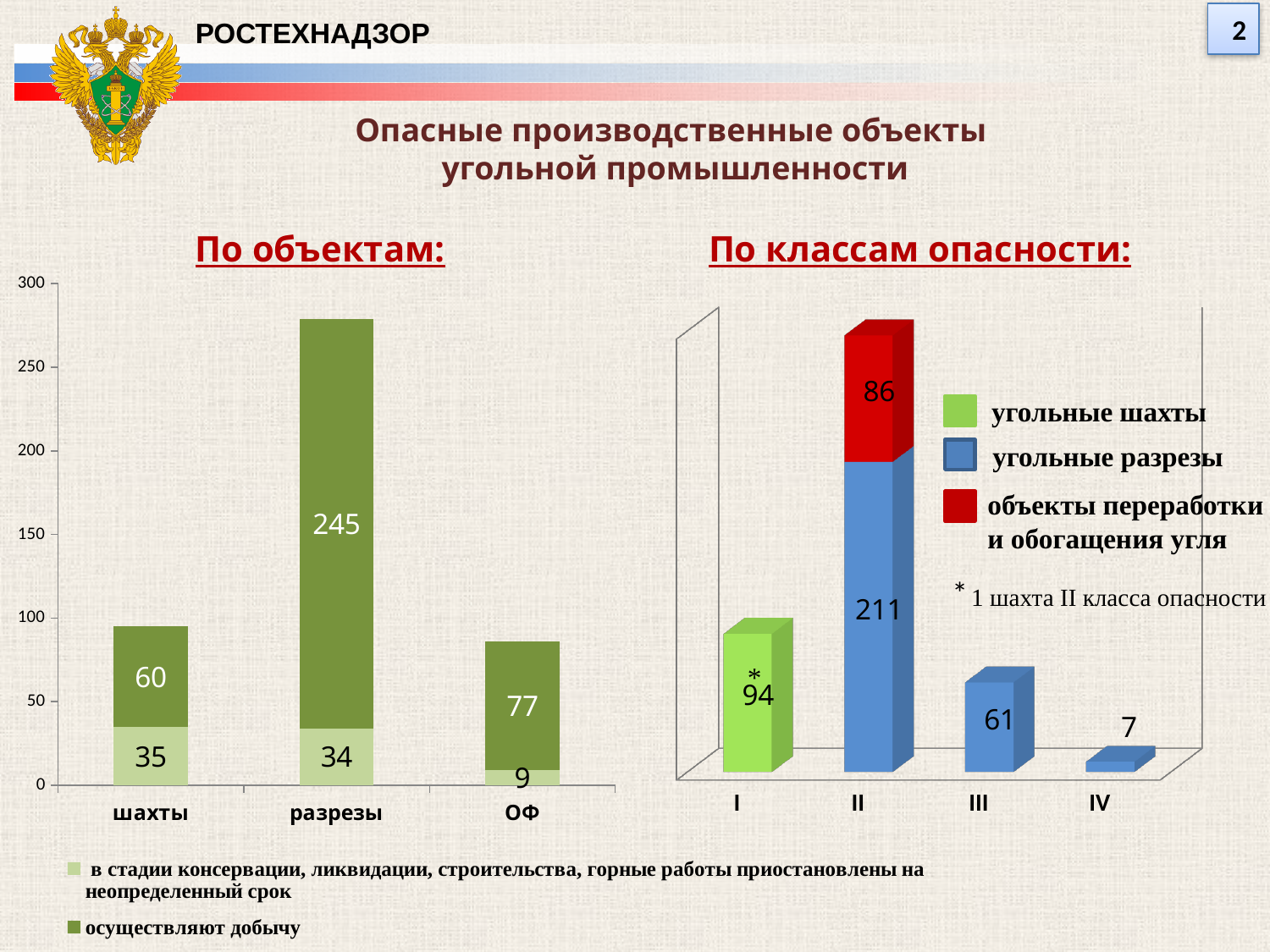
In the chart 'По объектам:', which category has the tallest stacked bar? разрезы In the chart 'По объектам:', what is the total of the stacked bar for 'ОФ'? 86 In the chart 'По классам опасности:', what is the total of the stacked bar for class II? 297 In the chart 'По объектам:', what is the value of the 'осуществляют добычу' segment for 'разрезы'? 245 In the chart 'По классам опасности:', how many series does the legend list? 3 In the chart 'По классам опасности:', which class has the lowest value? IV In the chart 'По объектам:', what is the difference between the 'осуществляют добычу' values for 'ОФ' and 'шахты'? 17 In the chart 'По объектам:', what is the value of the lower (light green) segment for 'шахты'? 35 In the chart 'По объектам:', how many categories are shown on the x axis? 3 In the chart 'По классам опасности:', what is the value of the red segment for class II? 86 In the chart 'По классам опасности:', which legend entry is shown in red? объекты переработки и обогащения угля In the chart 'По объектам:', what is the total of the stacked bar for 'шахты'? 95